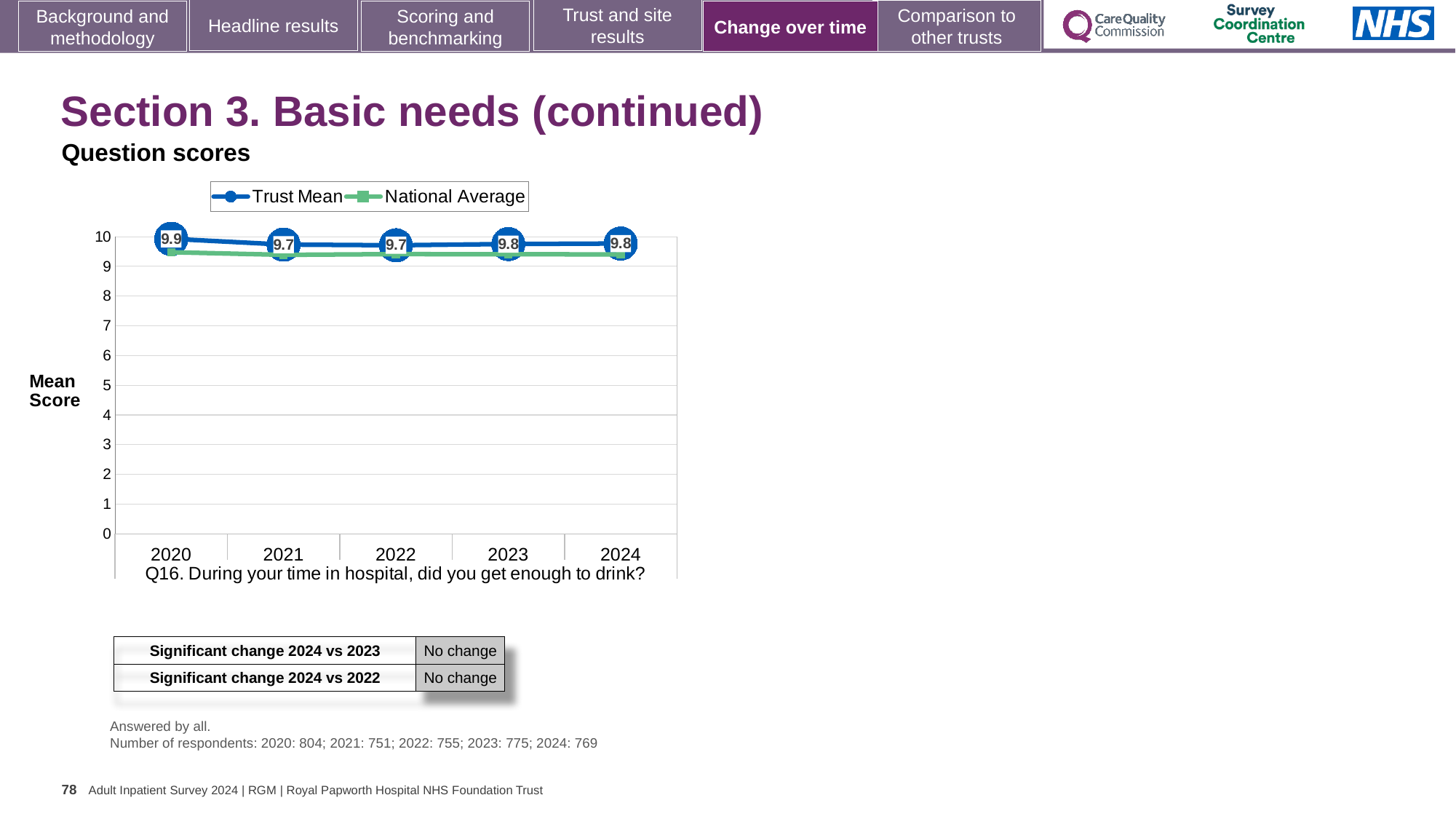
What is the Trust Mean score for 2024? 9.8 What is the Trust Mean score for 2020? 9.9 Which is larger, the Trust Mean score for 2020 or for 2023? 2020 In which year is the Trust Mean score highest? 2020 Which survey question does the chart show scores for? Q16. During your time in hospital, did you get enough to drink? What kind of chart is shown on the slide? line chart What is the Trust Mean score for 2022? 9.7 How many years are plotted on the x axis? 5 What is the difference between the Trust Mean scores for 2020 and 2021? 0.2 How many series does the legend list? 2 Is the Trust Mean score in 2024 higher or lower than in 2020? lower Is the National Average value for 2024 greater or less than 9? greater